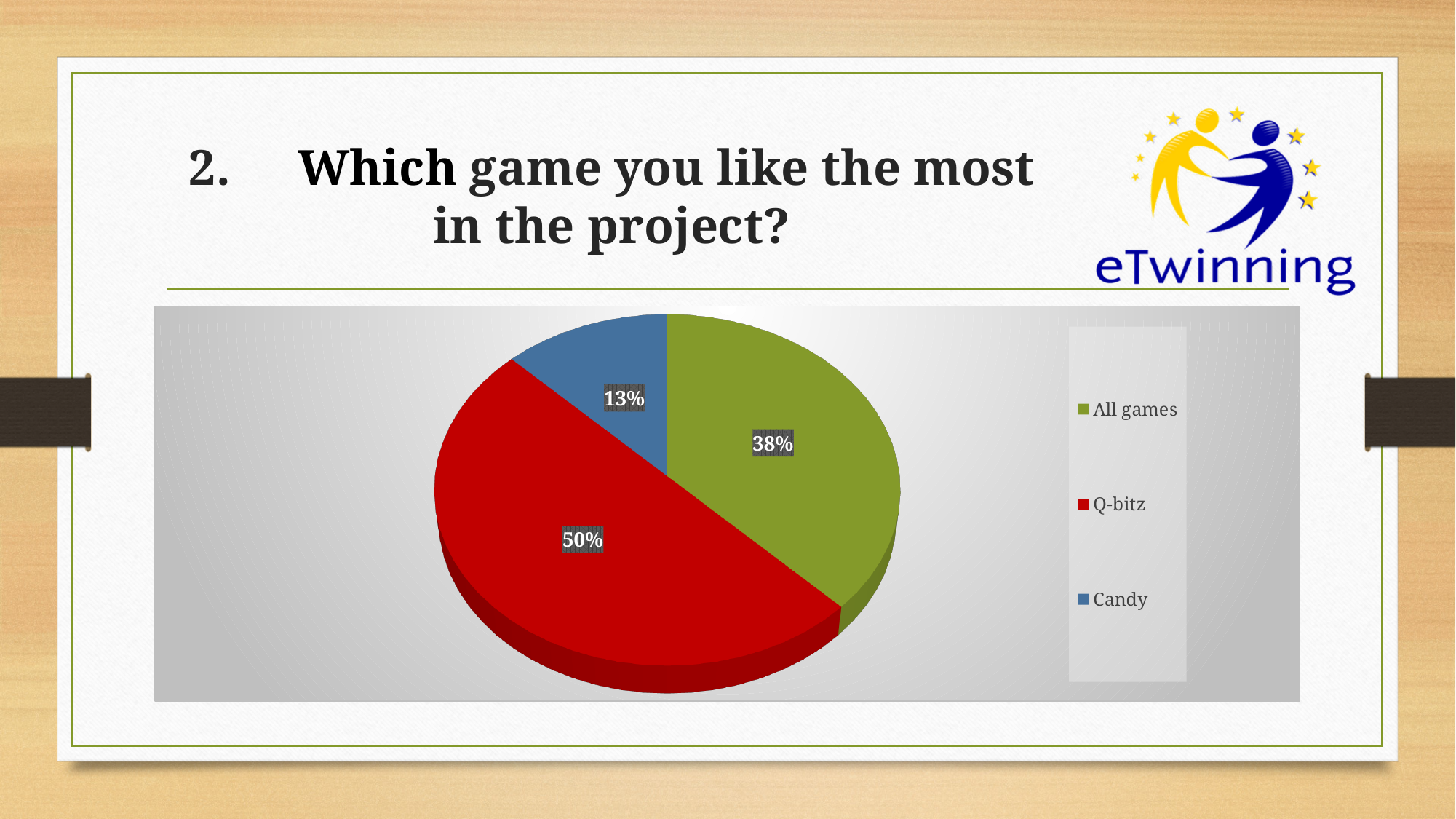
What is the title of the slide containing the chart? 2. Which game you like the most in the project? Which game has the smallest share of the pie? Candy Which colour represents Q-bitz in the pie chart? red Which game has the largest share of the pie? Q-bitz What is the difference in percentage points between Q-bitz and Candy? 37 Which has a larger share, All games or Candy? All games How many slices does the pie chart have? 3 What share of the pie does All games have? 38% What share of the pie does Candy have? 13% What share of the pie does Q-bitz have? 50% What kind of chart is shown on the slide? pie chart What is the difference in percentage points between All games and Candy? 25